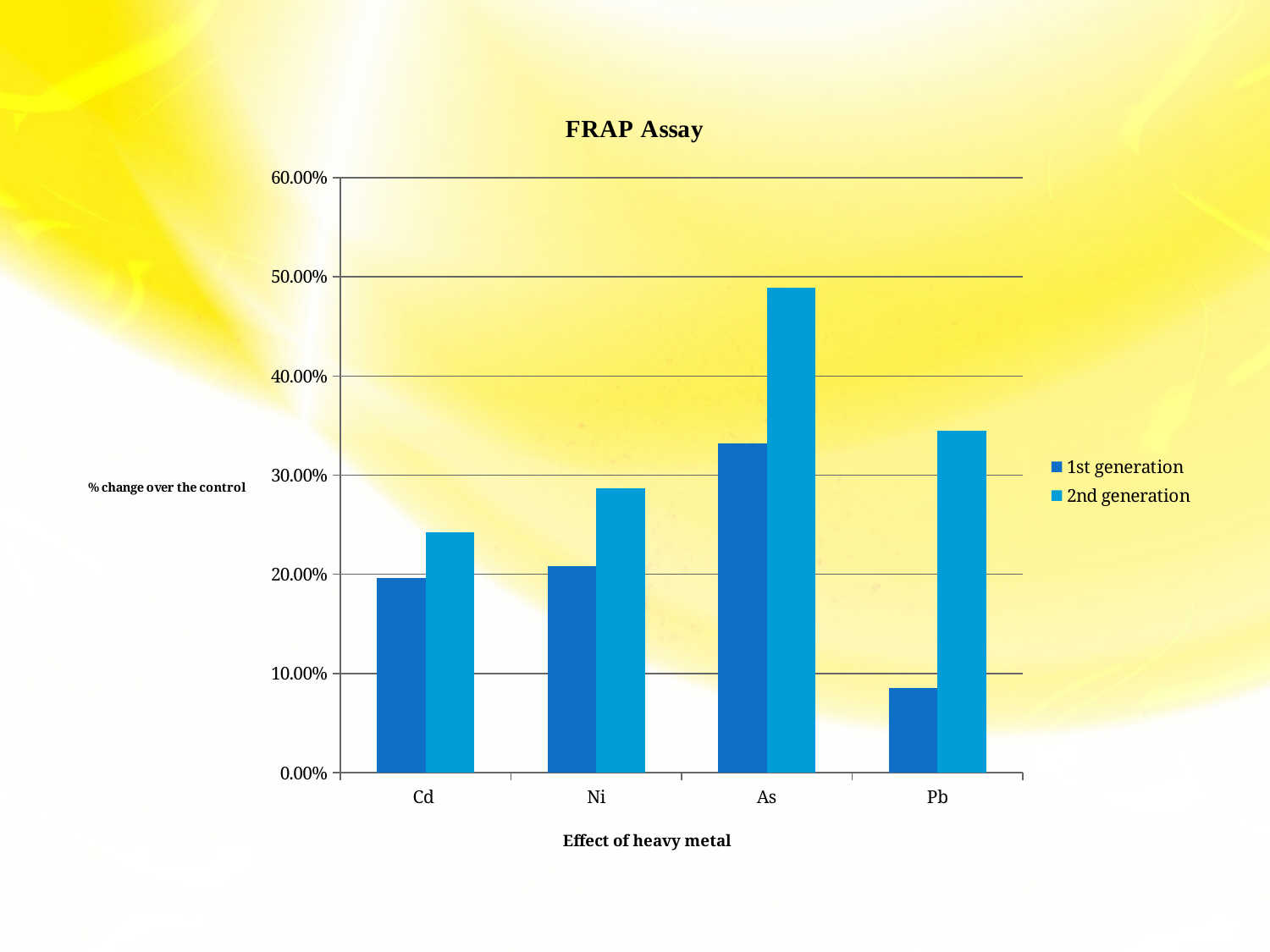
Is the 1st generation value for Pb greater or less than 10.00%? less Is the 2nd generation value for As greater or less than 40.00%? greater What is the title of the chart? FRAP Assay Which heavy metal has the highest value for the 2nd generation series? As What is the label of the x axis? Effect of heavy metal What kind of chart is shown on the slide? bar chart Which heavy metal has the highest value for the 1st generation series? As For Pb, which series has the larger value, 1st generation or 2nd generation? 2nd generation Which heavy metal has the lowest value for the 1st generation series? Pb How many series does the legend list? 2 How many heavy metal categories are shown on the x axis? 4